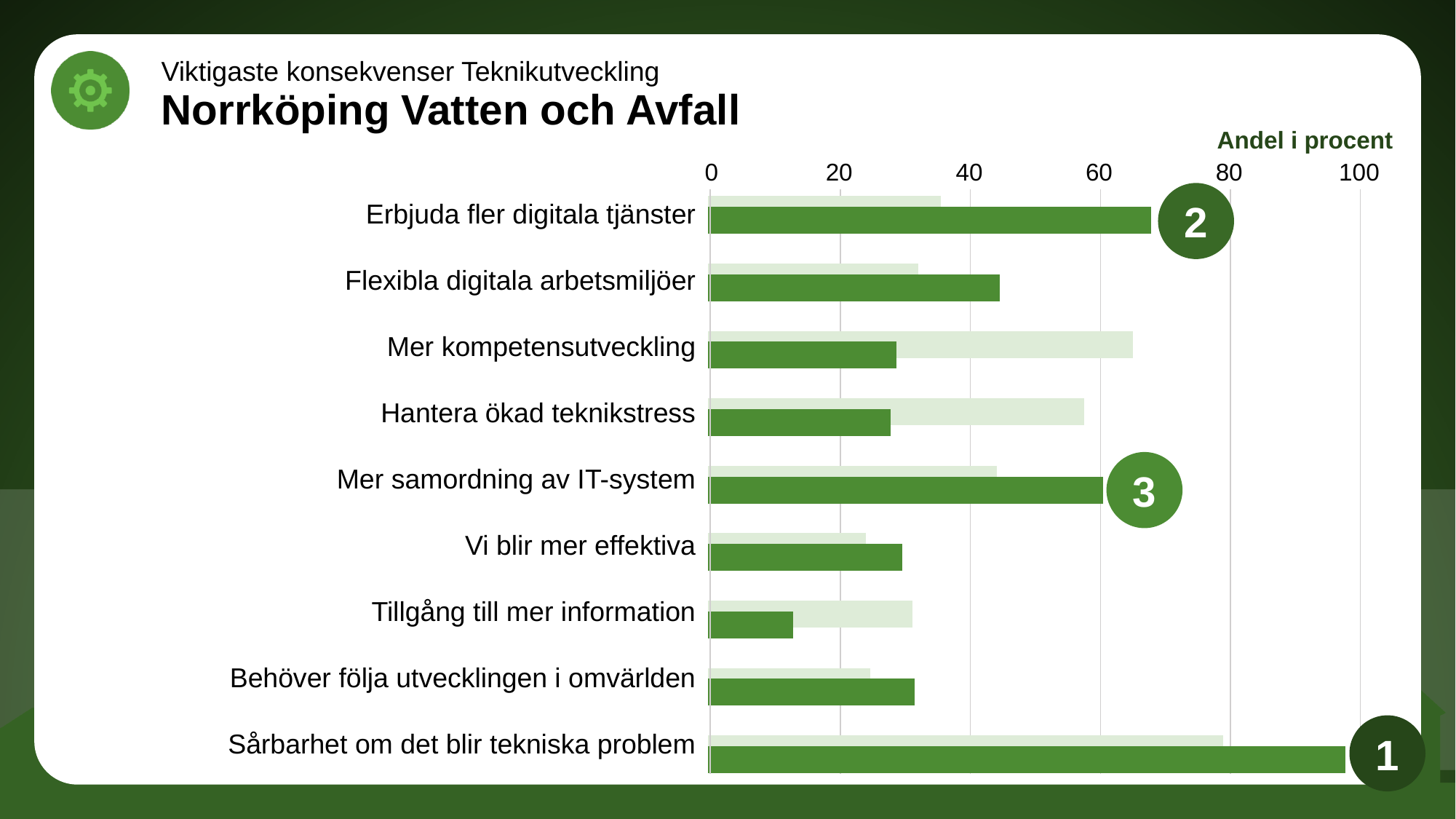
Is the light green value for Mer kompetensutveckling greater or less than 60? greater Which category is marked with the circled number 1? Sårbarhet om det blir tekniska problem For Hantera ökad teknikstress, which bar is longer, the dark green or the light green? light green Which category has the shortest dark green bar? Tillgång till mer information Is the dark green value for Sårbarhet om det blir tekniska problem greater or less than 80? greater What is the axis title shown above the horizontal axis? Andel i procent Is the dark green value for Erbjuda fler digitala tjänster greater or less than 60? greater Which category has the longest dark green bar? Sårbarhet om det blir tekniska problem What kind of chart is shown on the slide? bar chart Which has the larger dark green value, Mer samordning av IT-system or Vi blir mer effektiva? Mer samordning av IT-system How many categories are listed on the chart? 9